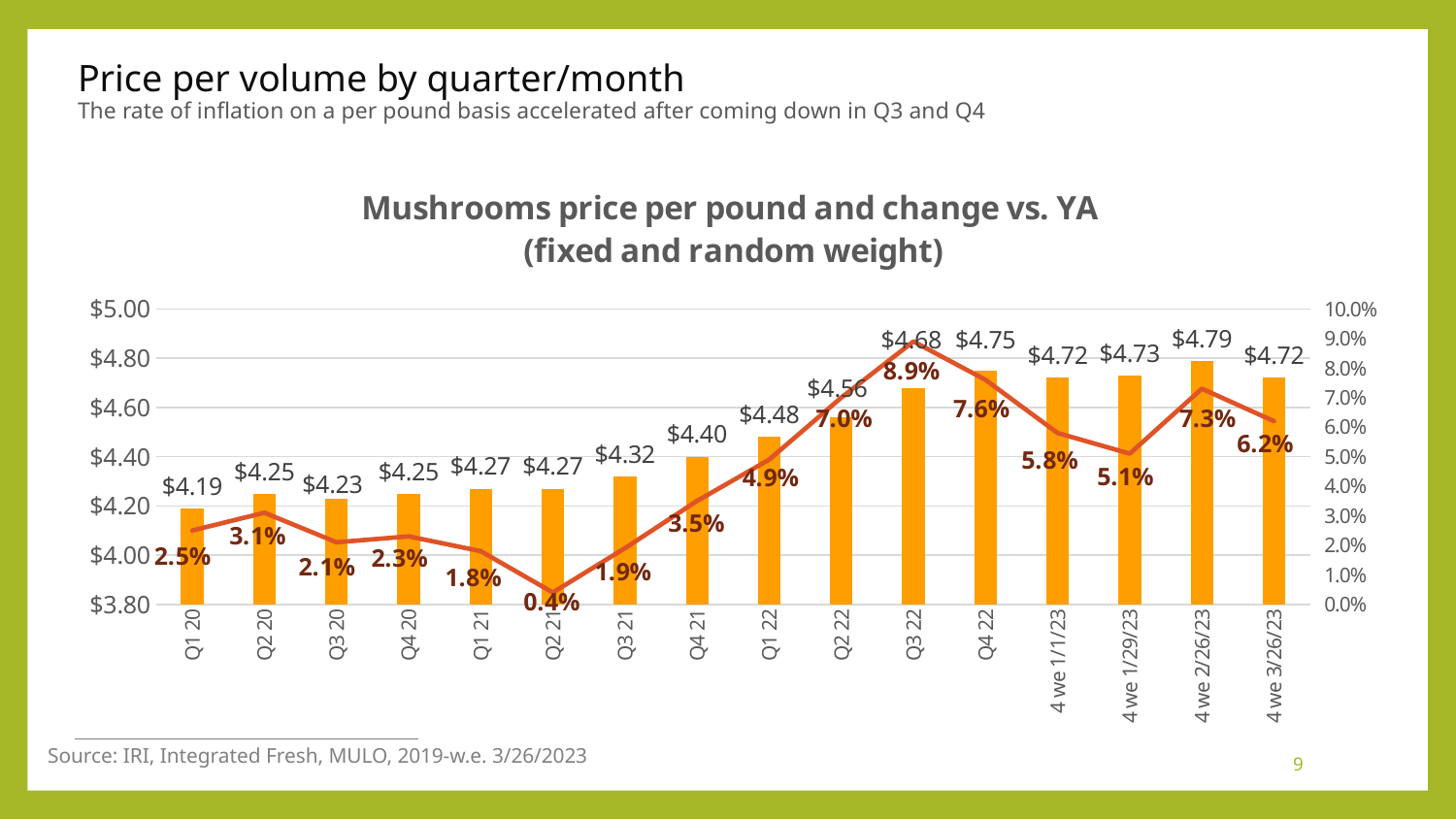
Does the price per pound generally rise or fall from Q1 20 to Q4 22? Rise Which period has the lowest change vs. YA? Q2 21 Which period has the highest price per pound? 4 we 2/26/23 How many periods are shown on the x axis? 16 What is the change vs. YA shown for Q3 22? 8.9% Which is larger, the change vs. YA for Q4 22 or for 4 we 1/29/23? Q4 22 Which period has the highest change vs. YA? Q3 22 What is the difference in price per pound between Q4 22 and Q1 20? $0.56 What is the price per pound for the 4 we 3/26/23 period? $4.72 What is the mushrooms price per pound for Q1 20? $4.19 What kind of chart is this? Combination bar and line chart What is the change vs. YA for Q2 21? 0.4%